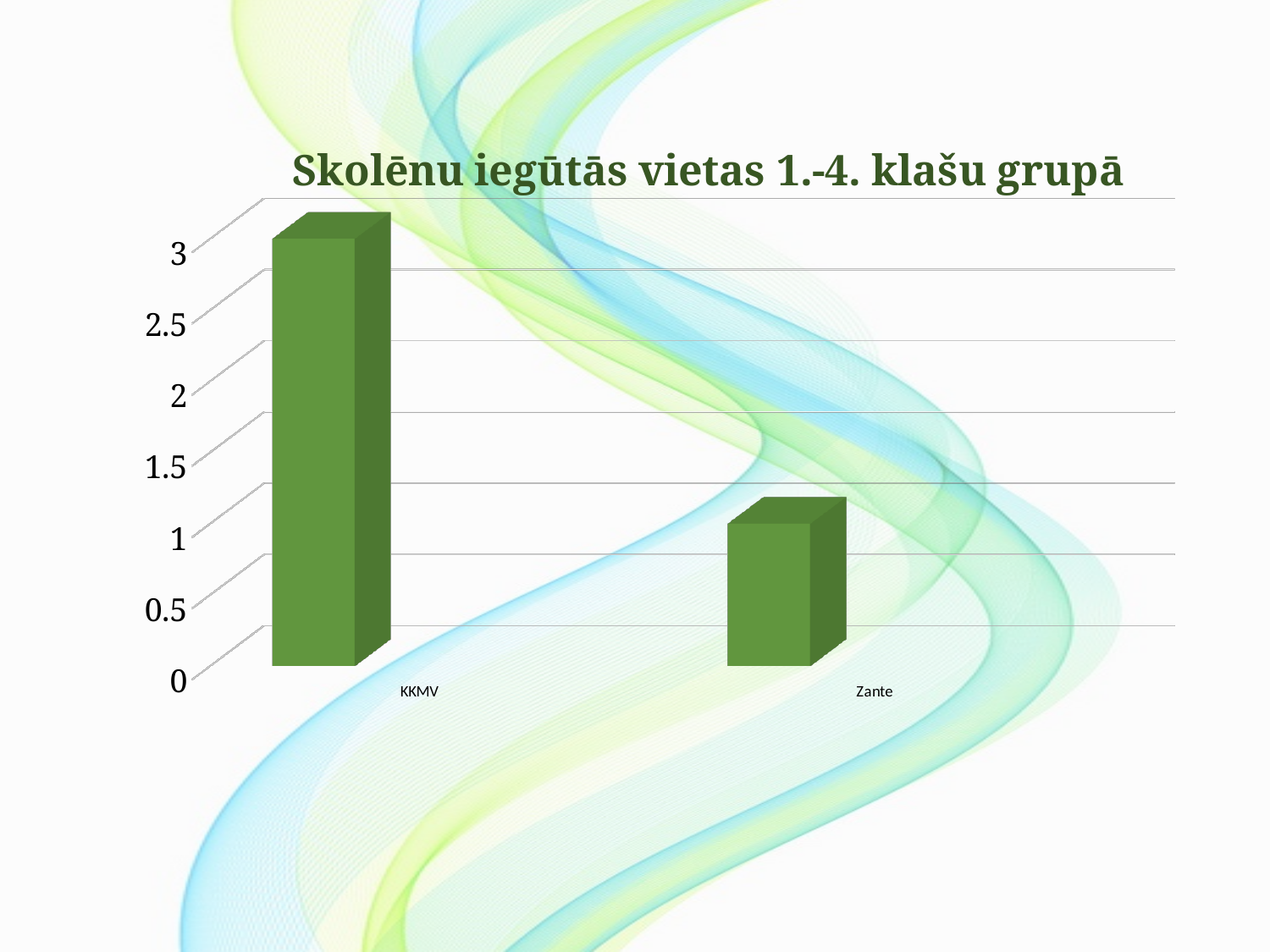
Do the values rise or fall from KKMV to Zante along the x axis? fall What is the value for Zante? 1 Which is larger, the value for KKMV or the value for Zante? KKMV Is the value for KKMV greater or less than 2? greater Is the value for Zante greater or less than 2? less What kind of chart is shown on the slide? bar chart What is the value for KKMV? 3 Which category has the lowest bar in the chart? Zante What is the title of the chart? Skolēnu iegūtās vietas 1.-4. klašu grupā What is the highest value shown on the vertical axis? 3 How many categories are shown on the x axis of the chart? 2 Which category has the highest bar in the chart? KKMV